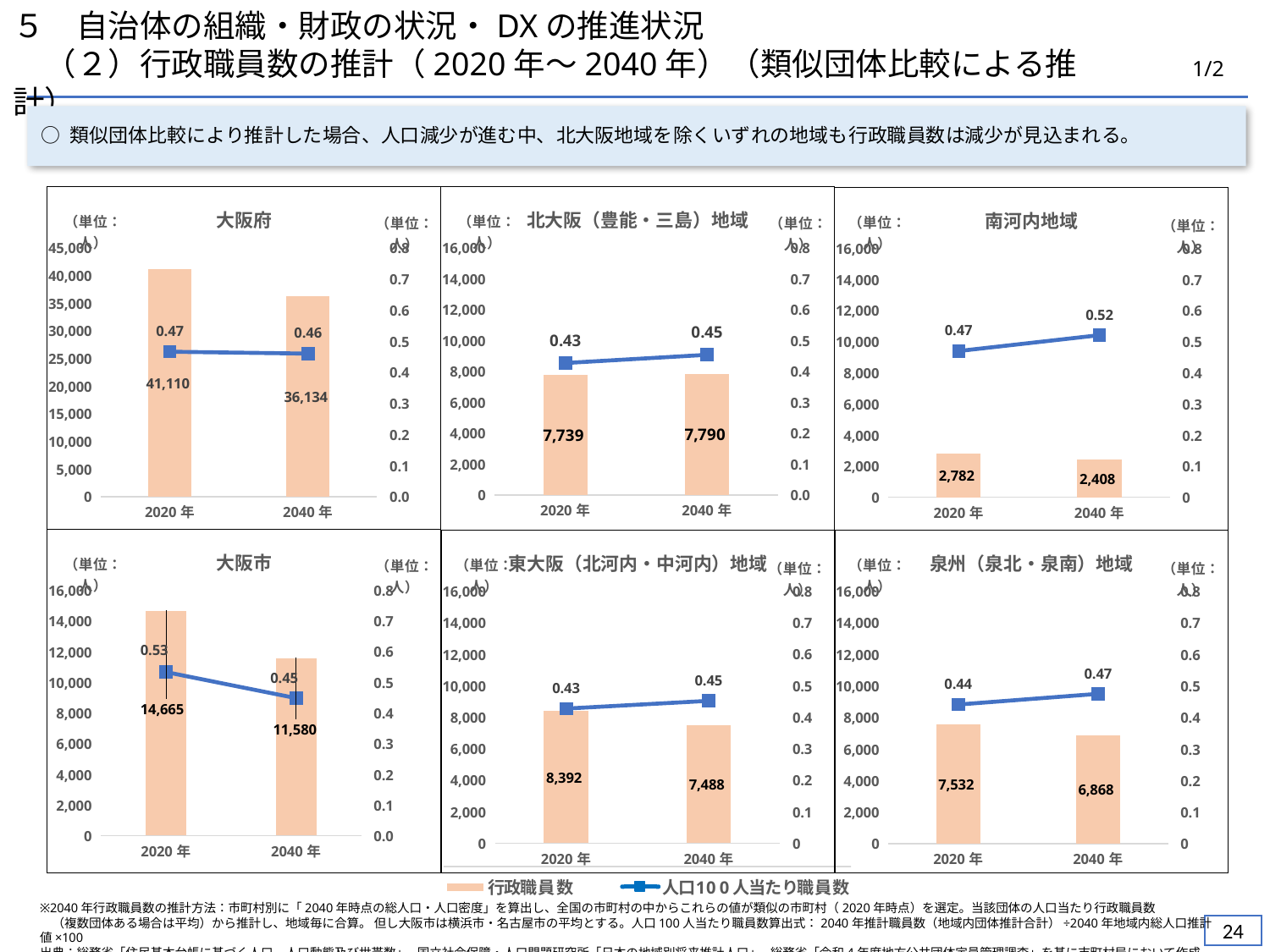
In the 南河内地域 chart, what is the difference in 行政職員数 between 2020年 and 2040年? 374 In the 泉州（泉北・泉南）地域 chart, what is the 行政職員数 value for 2040年? 6,868 In the 北大阪（豊能・三島）地域 chart, what is the 行政職員数 value for 2040年? 7,790 In the 泉州（泉北・泉南）地域 chart, what kind of chart is used to show 行政職員数? bar chart In the 東大阪（北河内・中河内）地域 chart, what is the difference in 行政職員数 between 2020年 and 2040年? 904 In the 大阪市 chart, does the 行政職員数 rise or fall from 2020年 to 2040年? fall In the 大阪府 chart, what is the 人口100人当たり職員数 value for 2040年? 0.46 In the 大阪市 chart, what is the 人口100人当たり職員数 value for 2020年? 0.53 In the 大阪府 chart, what is the 行政職員数 value for 2020年? 41,110 In the 北大阪（豊能・三島）地域 chart, which year has the higher 行政職員数 value, 2020年 or 2040年? 2040年 How many series does the shared legend at the bottom of the slide list? 2 In the 南河内地域 chart, what is the 人口100人当たり職員数 value for 2040年? 0.52